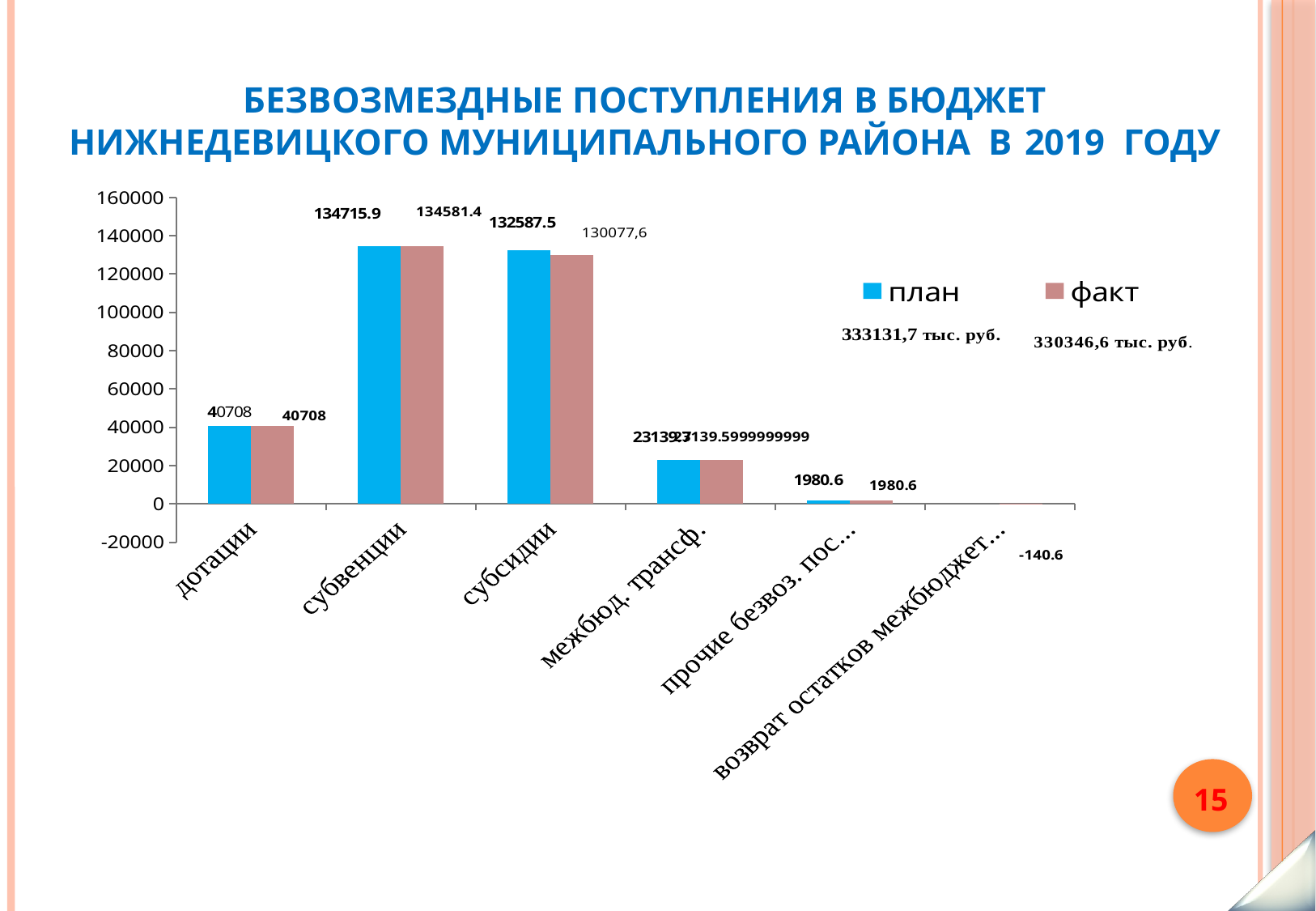
What is the факт value for субсидии? 130077,6 How many categories are shown on the x axis? 6 Is the факт value for субсидии greater or less than 120000? greater Which category has the highest план value? субвенции What is the difference between the план and факт values for субвенции? 134.5 What total is printed on the slide for план, in тыс. руб.? 333131,7 тыс. руб. How many series does the legend list? 2 What is the факт value for возврат остатков межбюджет…? -140.6 What kind of chart is shown on the slide? bar chart For субсидии, which is larger: план or факт? план What is the план value for субвенции? 134715.9 What is the план value for дотации? 40708